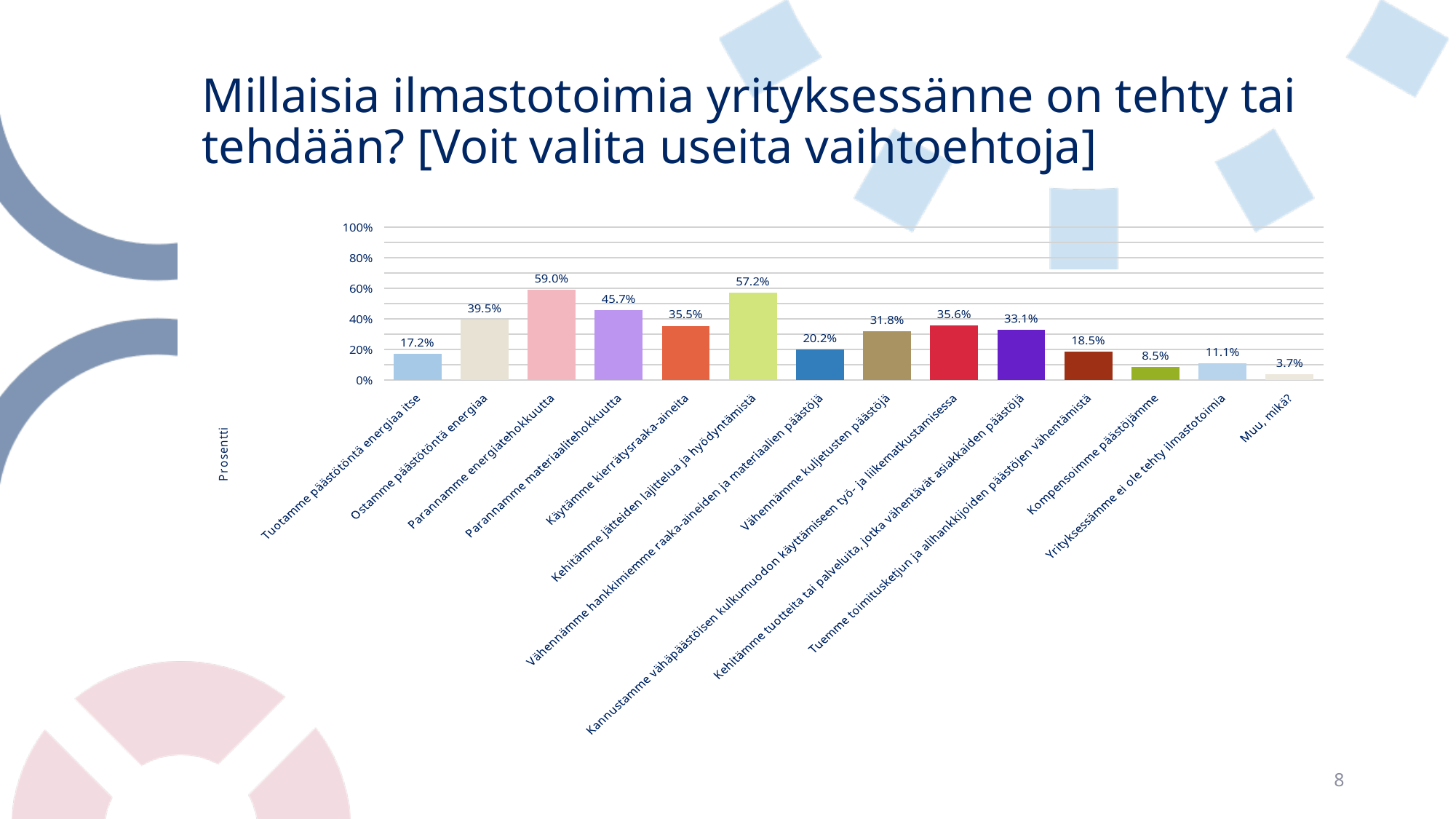
What is the value for "Parannamme energiatehokkuutta"? 59.0% What is the difference between "Tuotamme päästötöntä energiaa itse" and "Muu, mikä?"? 13.5% What is the value for "Yrityksessämme ei ole tehty ilmastotoimia"? 11.1% How many categories are shown in the chart? 14 What kind of chart is shown on the slide? Bar chart What is the label on the vertical axis of the chart? Prosentti Which category has the lowest value? Muu, mikä? Is the value for "Vähennämme kuljetusten päästöjä" greater or less than 40%? less Which is larger: "Ostamme päästötöntä energiaa" or "Parannamme materiaalitehokkuutta"? Parannamme materiaalitehokkuutta What is the difference between "Parannamme energiatehokkuutta" and "Kehitämme jätteiden lajittelua ja hyödyntämistä"? 1.8% What is the value for "Kompensoimme päästöjämme"? 8.5% Which category has the highest value? Parannamme energiatehokkuutta